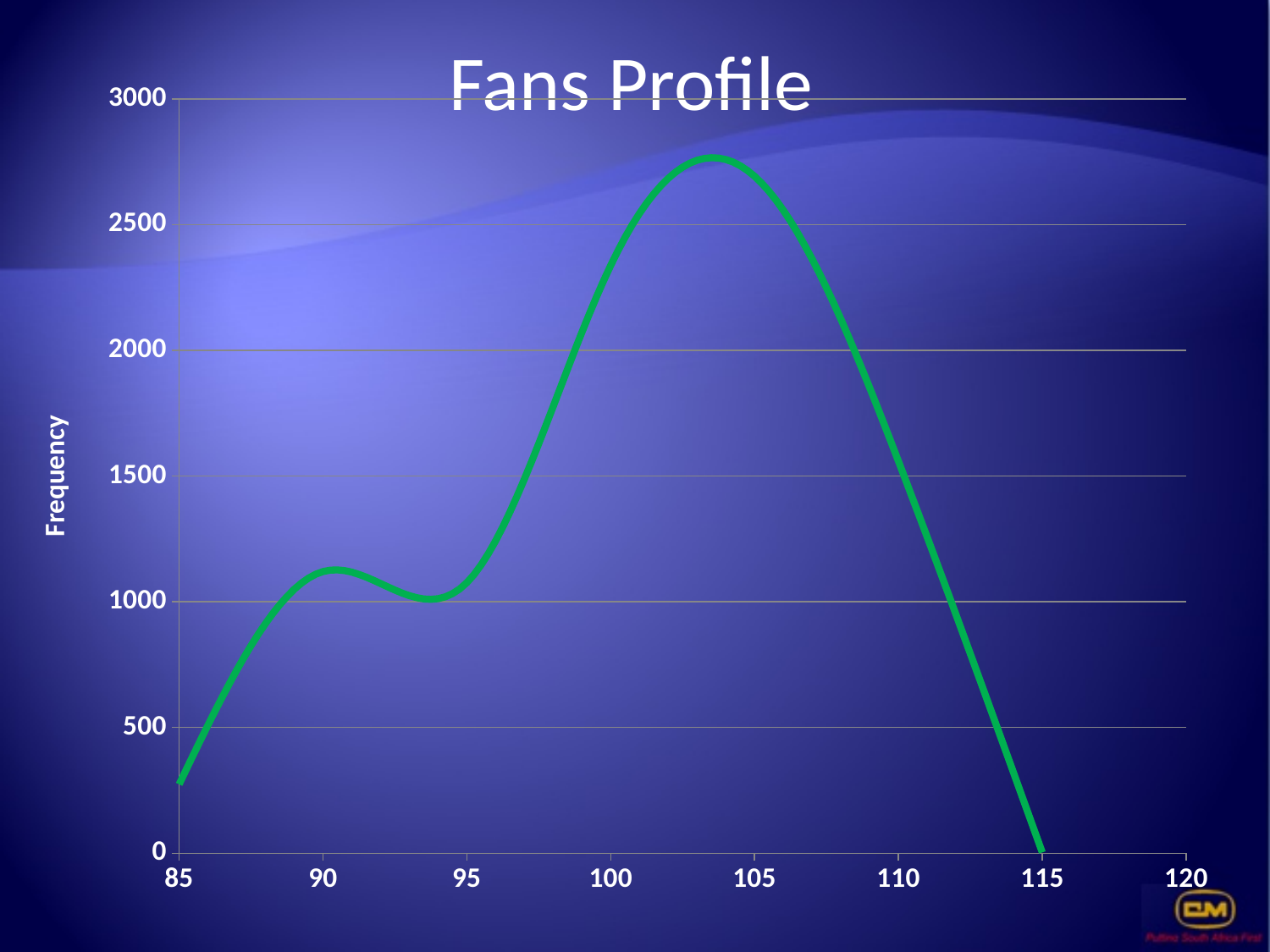
Is the value of the line at x = 95 greater or less than 1500? less Does the line rise or fall between x = 105 and x = 115? fall Is the value of the line at x = 100 greater or less than 2000? greater Is the value of the line at x = 110 greater or less than 2000? less Does the line rise or fall between x = 95 and x = 100? rise What kind of chart is shown on the slide? line chart What is the title of the chart? Fans Profile What is the label on the vertical axis of the chart? Frequency Between which two x-axis ticks does the line reach its highest point? 100 and 105